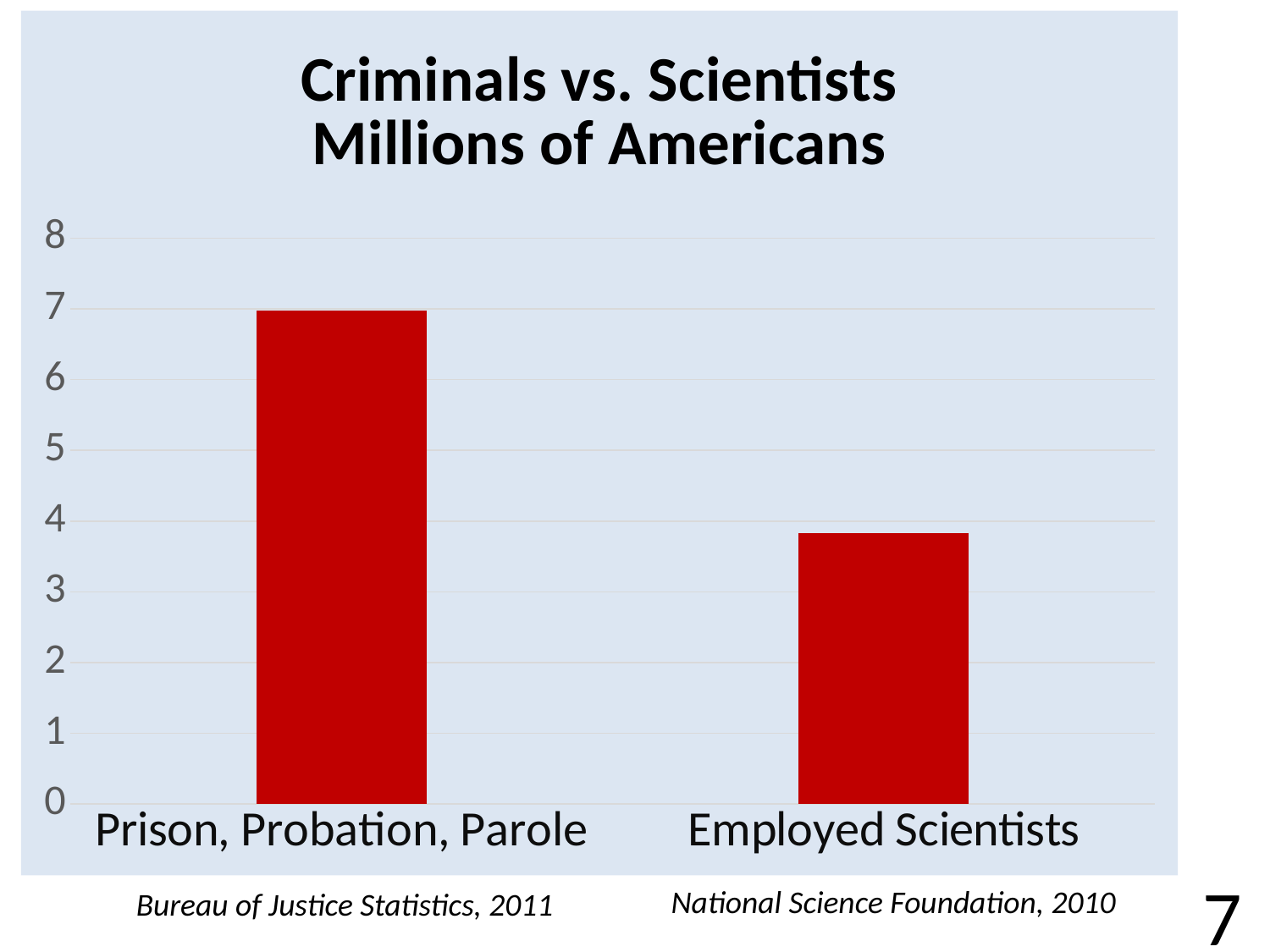
How many categories are shown in the chart? 2 What is the title of the chart? Criminals vs. Scientists Millions of Americans Is the value for Employed Scientists greater or less than 4? less Which is larger, the value for Prison, Probation, Parole or the value for Employed Scientists? Prison, Probation, Parole Is the value for Prison, Probation, Parole greater or less than 6? greater What is the highest value shown on the vertical axis? 8 What type of chart is shown on the slide? bar chart Which category has the lowest value? Employed Scientists Is the value for Employed Scientists greater or less than 3? greater Which category has the highest value? Prison, Probation, Parole